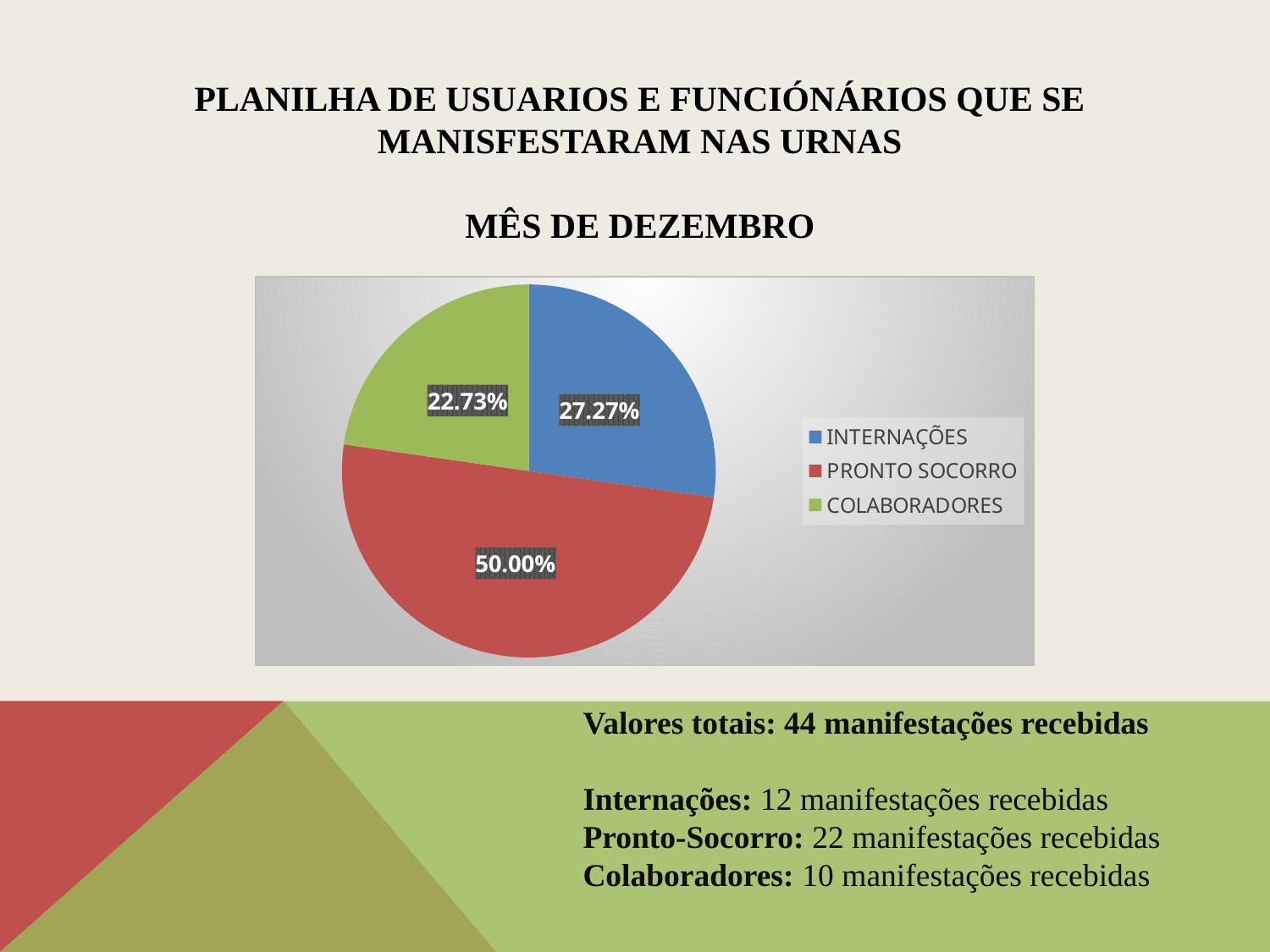
What colour is the COLABORADORES slice? green What share of the pie does INTERNAÇÕES represent? 27.27% What kind of chart is shown on the slide? pie chart How many slices does the pie chart have? 3 What is the difference in percentage points between the PRONTO SOCORRO slice and the INTERNAÇÕES slice? 22.73% What colour is the PRONTO SOCORRO slice? red What share of the pie does COLABORADORES represent? 22.73% Which category has the smallest slice of the pie? COLABORADORES Which is larger, the INTERNAÇÕES slice or the COLABORADORES slice? INTERNAÇÕES Which category has the largest slice of the pie? PRONTO SOCORRO What share of the pie does PRONTO SOCORRO represent? 50.00% How many entries does the legend list? 3